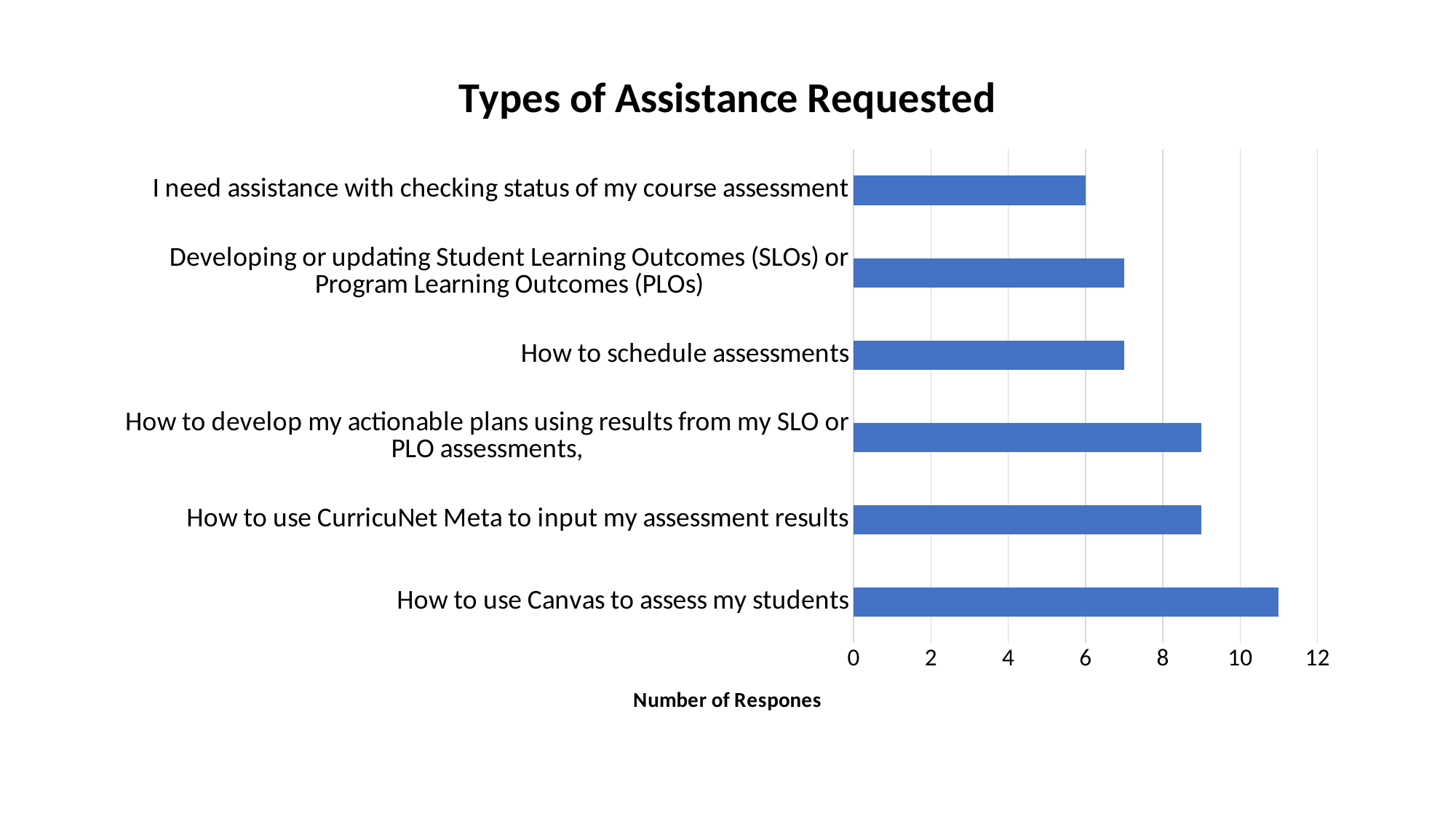
Which type of assistance received the highest number of responses? How to use Canvas to assess my students Which received more responses: 'How to use Canvas to assess my students' or 'How to use CurricuNet Meta to input my assessment results'? How to use Canvas to assess my students What is the label on the horizontal axis of the chart? Number of Respones Which type of assistance received the lowest number of responses? I need assistance with checking status of my course assessment How many responses were there for 'I need assistance with checking status of my course assessment'? 6 Is the number of responses for 'How to schedule assessments' greater or less than 8? less How many categories of assistance are shown in the chart? 6 Is the number of responses for 'How to use CurricuNet Meta to input my assessment results' greater or less than 8? greater Is the number of responses for 'How to use Canvas to assess my students' greater or less than 10? greater What is the title of the chart? Types of Assistance Requested What type of chart is shown on the slide? bar chart Which received more responses: 'How to develop my actionable plans using results from my SLO or PLO assessments,' or 'How to schedule assessments'? How to develop my actionable plans using results from my SLO or PLO assessments,